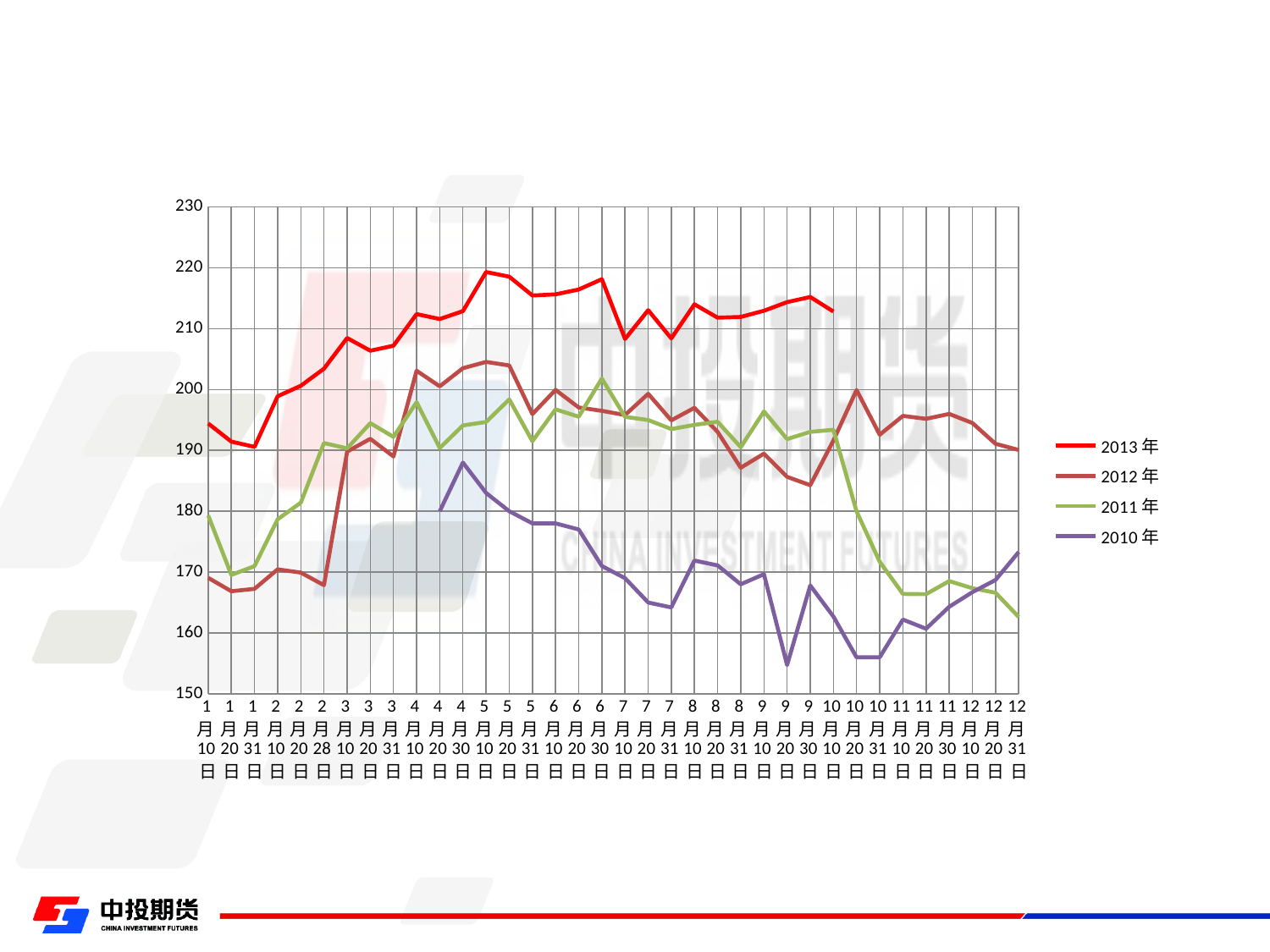
Is the value for 2013年 at 5月10日 greater or less than 210? greater Does the 2011年 series rise or fall between 10月10日 and 11月10日? fall On which date does the 2013年 series reach its highest value? 5月10日 What kind of chart is shown on the slide? line chart At 4月30日, which series has the larger value, 2013年 or 2010年? 2013年 At 10月20日, which series has the larger value, 2012年 or 2011年? 2012年 Is the value for 2011年 at 12月31日 greater or less than 170? less Is the value for 2012年 at 1月20日 greater or less than 170? less How many series does the legend list? 4 How many date categories are shown along the x axis? 36 On which date does the 2010年 series reach its lowest value? 9月20日